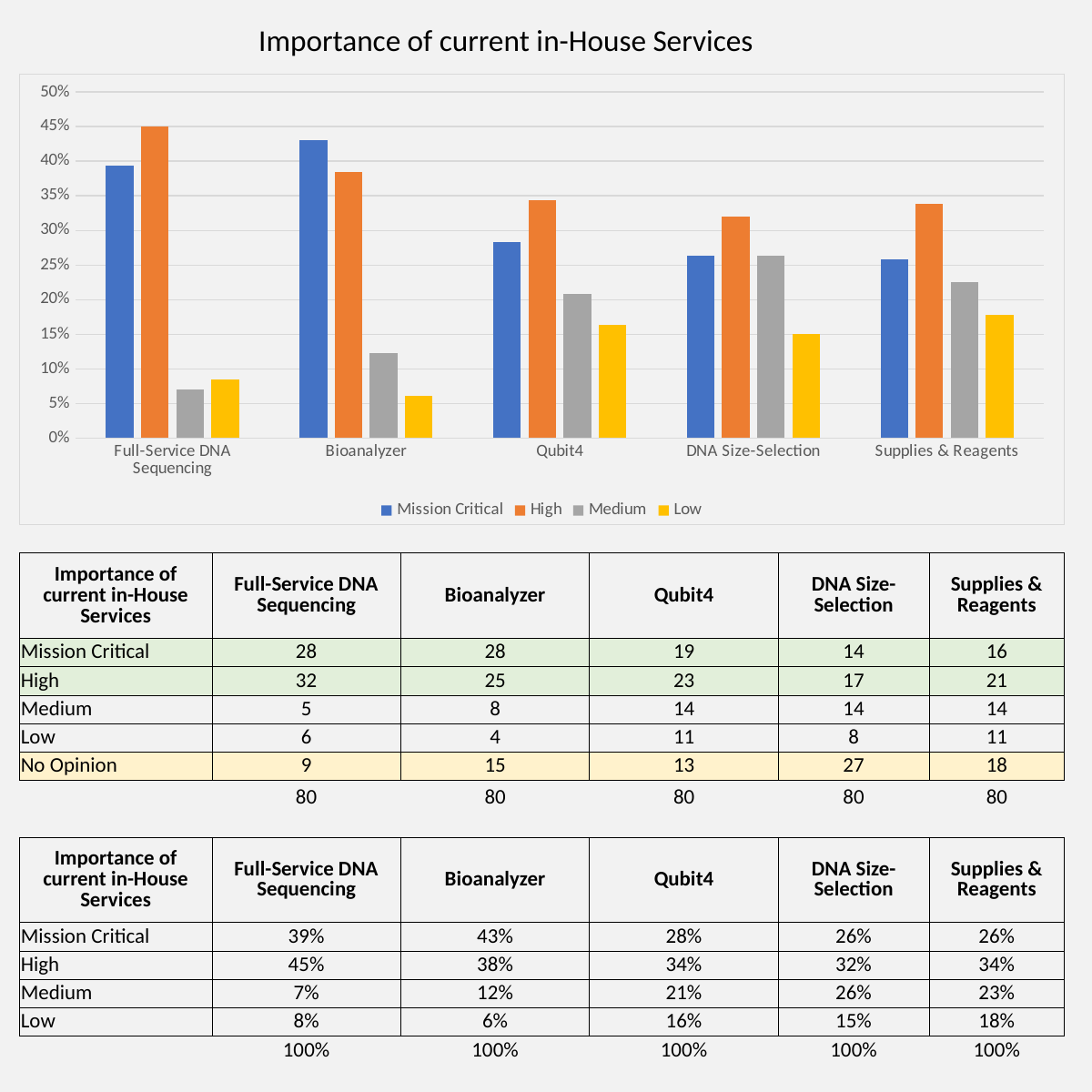
Which service has the lowest Low bar? Bioanalyzer How many series does the chart legend list? 4 Is the Medium value for Full-Service DNA Sequencing greater or less than 10%? less What colour represents the Low series in the chart? yellow Which service has the highest Medium bar? DNA Size-Selection For Full-Service DNA Sequencing, which is larger: High or Mission Critical? High Which service has the highest Mission Critical bar? Bioanalyzer What kind of chart is shown on the slide? bar chart For Bioanalyzer, which is larger: Mission Critical or High? Mission Critical What is the Mission Critical value for Bioanalyzer? 43% How many service categories are shown along the x axis of the chart? 5 Is the High value for Qubit4 greater or less than 30%? greater